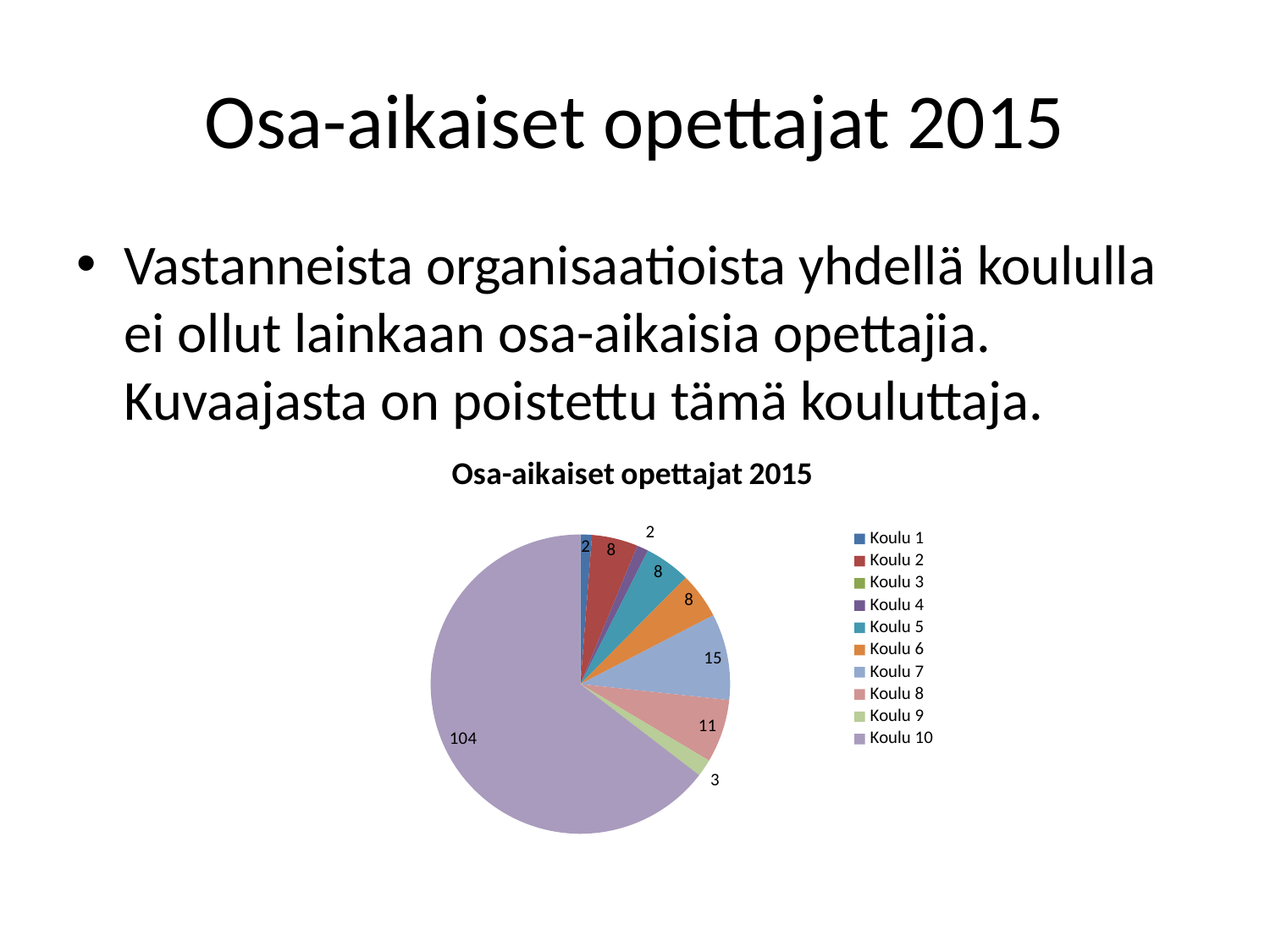
Which is larger, the value for Koulu 7 or the value for Koulu 8? Koulu 7 What is the value shown for Koulu 8? 11 What is the value shown for Koulu 6? 8 What is the value shown for Koulu 10? 104 What is the difference between the values for Koulu 10 and Koulu 7? 89 What is the value shown for Koulu 7? 15 How many entries does the chart legend list? 10 What is the title of the chart? Osa-aikaiset opettajat 2015 What is the value shown for Koulu 9? 3 What type of chart is shown on the slide? pie chart What is the difference between the values for Koulu 8 and Koulu 9? 8 Which school has the largest slice in the pie chart? Koulu 10